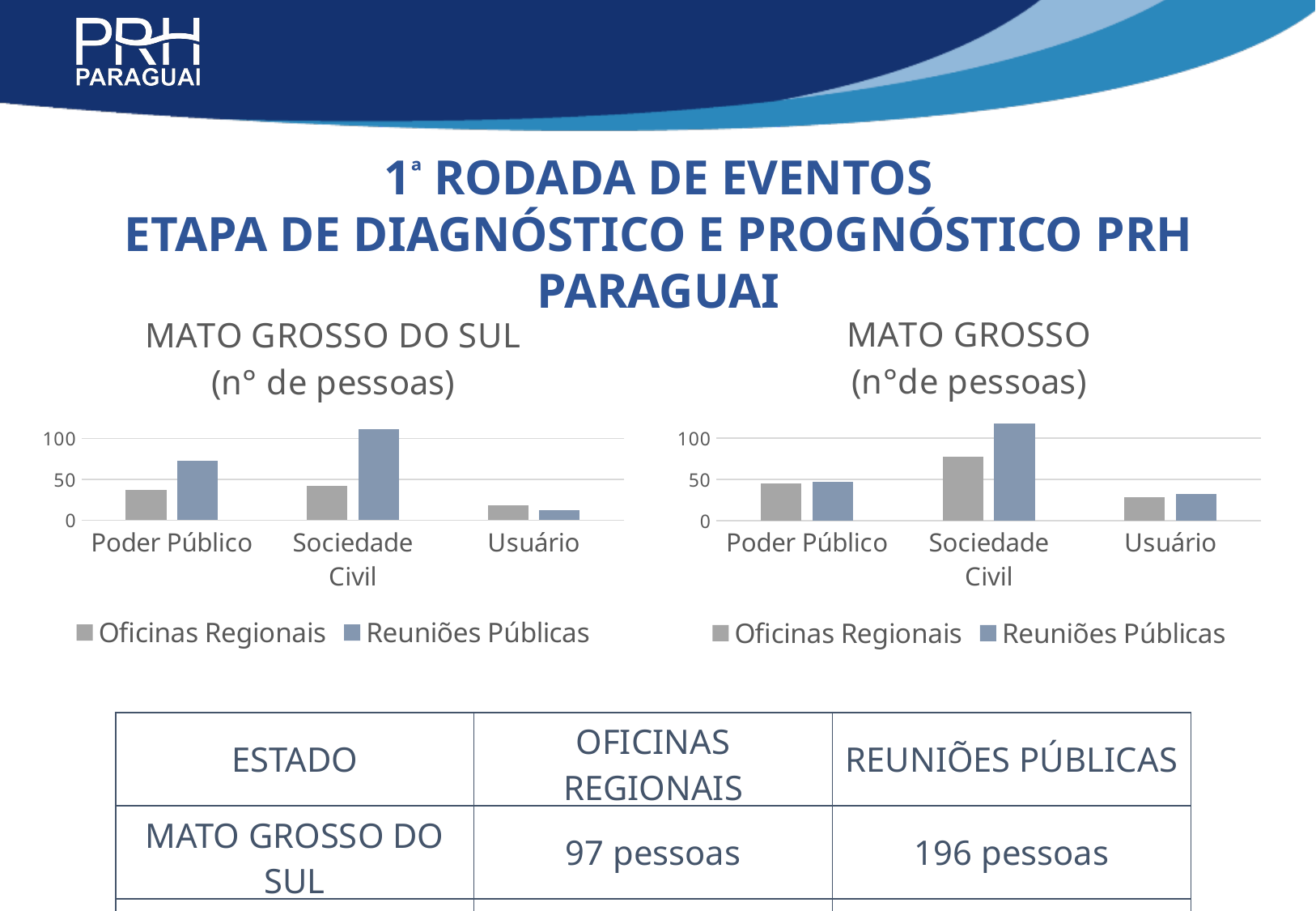
In the MATO GROSSO chart, is the Oficinas Regionais value for Sociedade Civil greater or less than 50? greater What kind of chart is the MATO GROSSO DO SUL (n° de pessoas) chart? bar chart In the MATO GROSSO chart, which category has the highest value for Reuniões Públicas? Sociedade Civil In the MATO GROSSO DO SUL chart, for Poder Público, which series has the larger value: Oficinas Regionais or Reuniões Públicas? Reuniões Públicas How many series does the legend of the MATO GROSSO DO SUL chart list? 2 In the MATO GROSSO DO SUL chart, is the Oficinas Regionais value for Poder Público greater or less than 50? less In the MATO GROSSO chart, which category has the lowest value for Oficinas Regionais? Usuário In the MATO GROSSO DO SUL chart, which category has the highest value for Reuniões Públicas? Sociedade Civil What are the two legend entries of the MATO GROSSO chart? Oficinas Regionais and Reuniões Públicas In the MATO GROSSO DO SUL chart, is the Reuniões Públicas value for Sociedade Civil greater or less than 100? greater How many categories are shown on the x axis of the MATO GROSSO (n°de pessoas) chart? 3